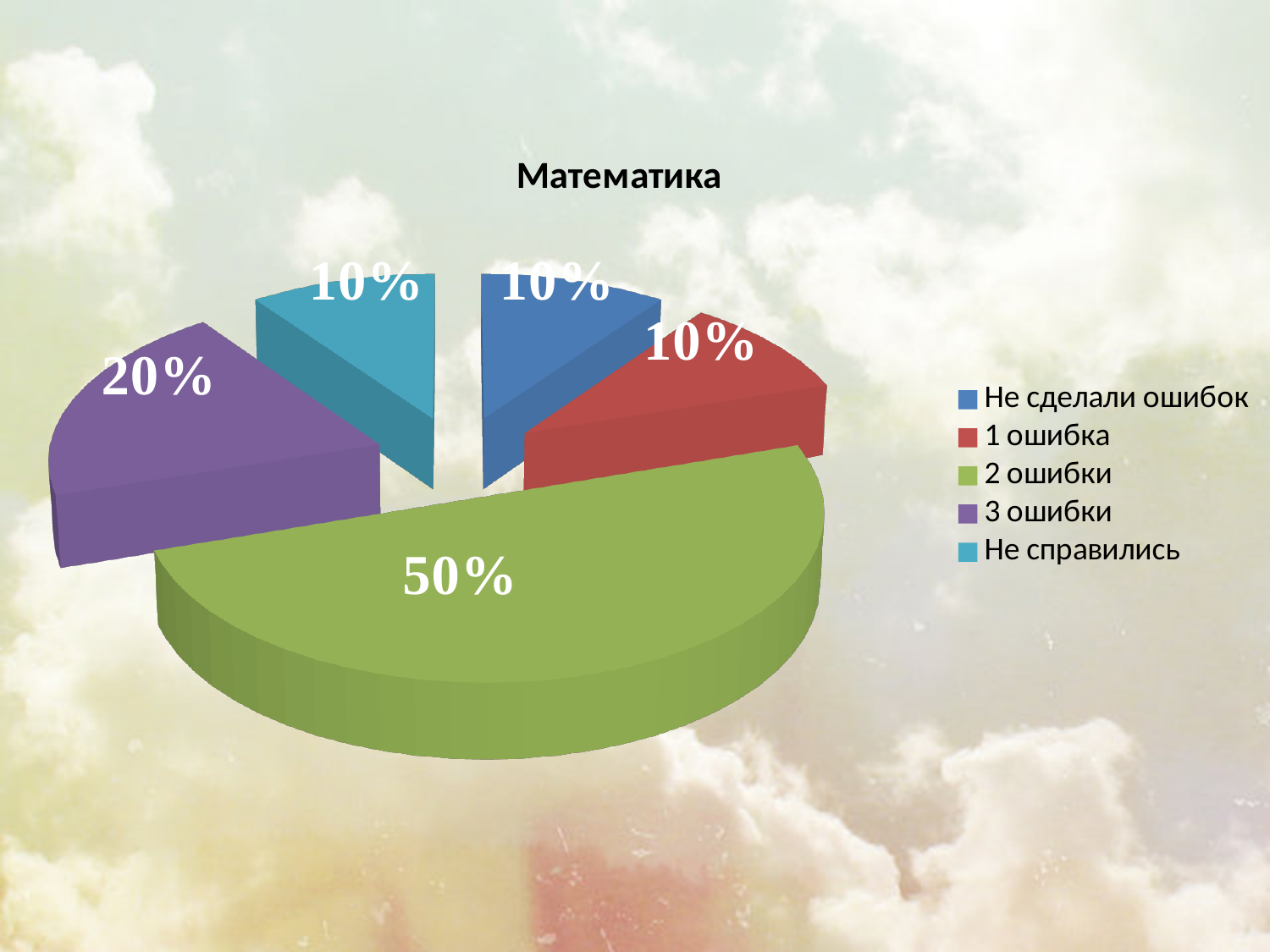
What share of the pie is labelled "2 ошибки"? 50% What is the combined share of "Не сделали ошибок" and "1 ошибка"? 20% What share of the pie is labelled "Не справились"? 10% What type of chart is shown on the slide? Pie chart What colour is the slice for "2 ошибки"? Green What share of the pie is labelled "Не сделали ошибок"? 10% What is the title of the chart? Математика What is the difference between the shares for "2 ошибки" and "3 ошибки"? 30% Which category has the largest slice of the pie? 2 ошибки How many categories does the legend list? 5 Which is larger, the share for "3 ошибки" or the share for "1 ошибка"? 3 ошибки What share of the pie is labelled "3 ошибки"? 20%